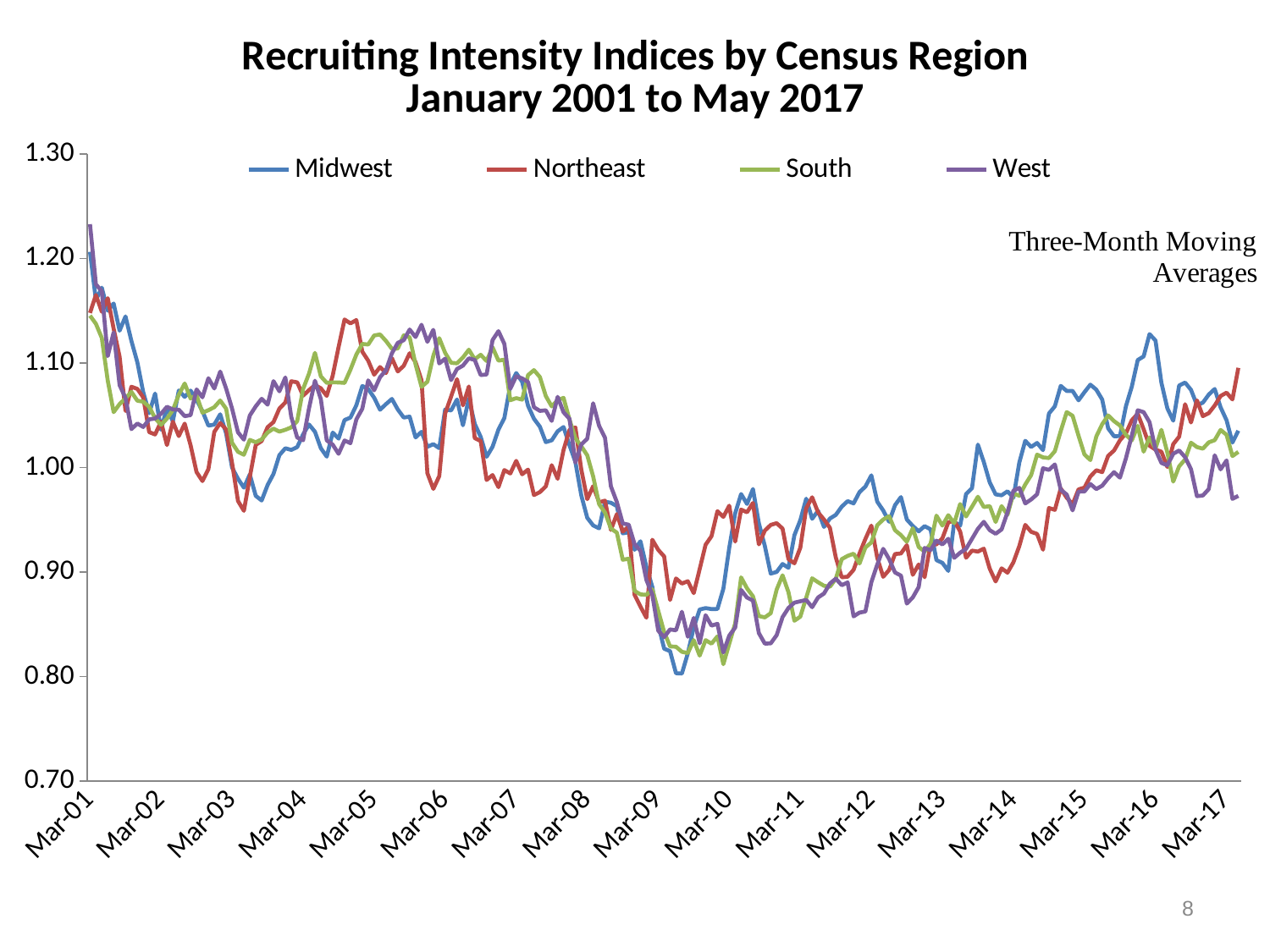
How many series does the legend list? 4 At the right end of the chart (around Mar-17), which series is higher, Northeast or West? Northeast Is the value for West at the right end of the chart (around Mar-17) greater or less than 1.00? less Which series is drawn in red in the chart? Northeast What kind of chart is shown on the slide? Line chart Between Mar-10 and Mar-15, do the series generally rise or fall? rise Is the value for Northeast at the right end of the chart (around Mar-17) greater or less than 1.00? greater What is the title of the chart? Recruiting Intensity Indices by Census Region January 2001 to May 2017 How many year labels (Mar-01 through Mar-17) are shown on the x axis? 17 Between Mar-08 and Mar-09, do the series generally rise or fall? fall Is the lowest value of the Midwest series, reached around late 2009, greater or less than 0.90? less